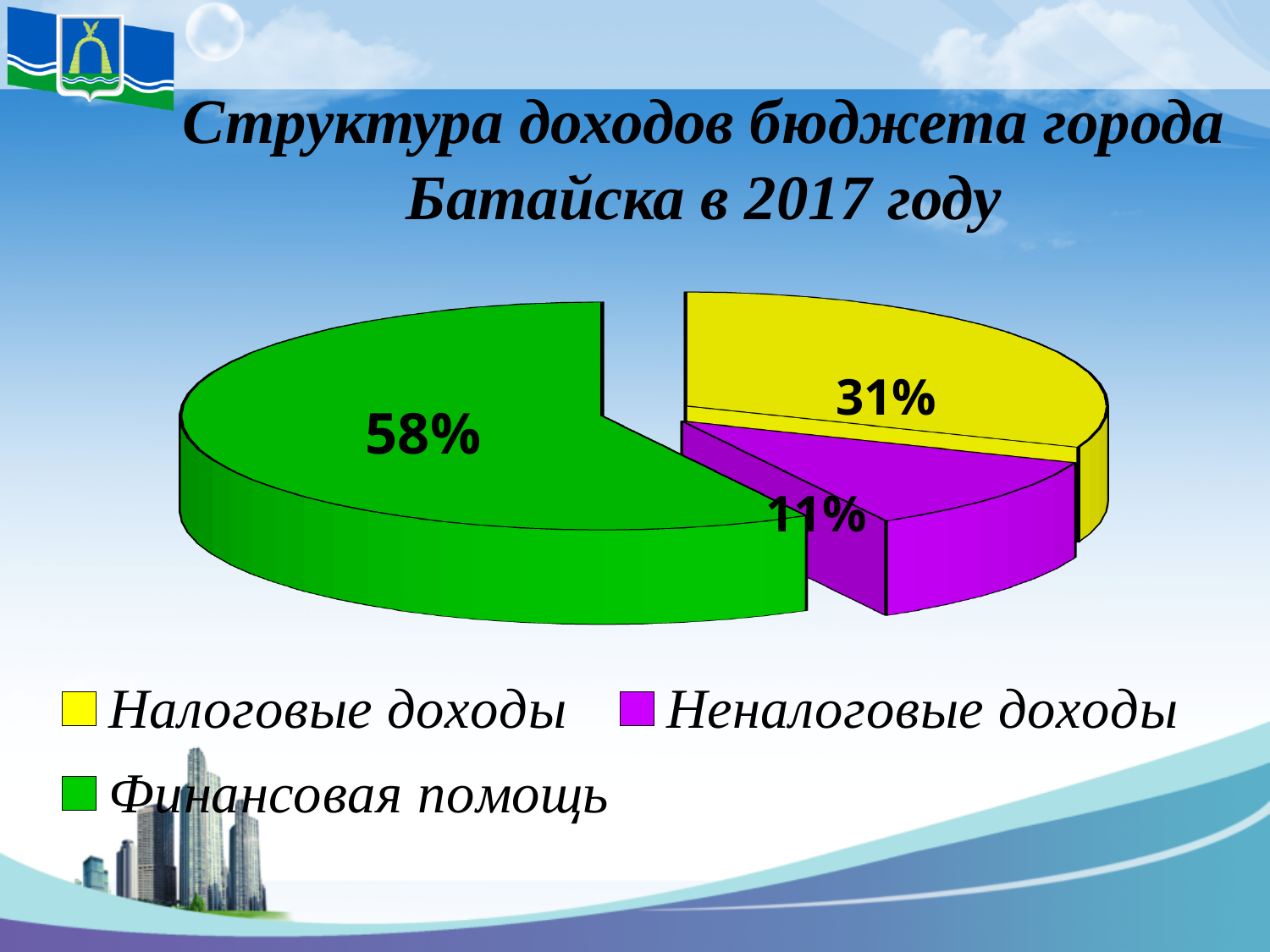
What is the difference in percentage points between Финансовая помощь and Налоговые доходы? 27 What share of the pie does Финансовая помощь represent? 58% What is the difference in percentage points between Налоговые доходы and Неналоговые доходы? 20 Which category has the largest share of the pie? Финансовая помощь What colour is the slice for Неналоговые доходы? Purple What is the title of the chart? Структура доходов бюджета города Батайска в 2017 году What share of the pie does Налоговые доходы represent? 31% What share of the pie does Неналоговые доходы represent? 11% What kind of chart is shown on the slide? Pie chart How many slices does the pie chart have? 3 Which is larger: the share for Налоговые доходы or the share for Неналоговые доходы? Налоговые доходы Which category has the smallest share of the pie? Неналоговые доходы